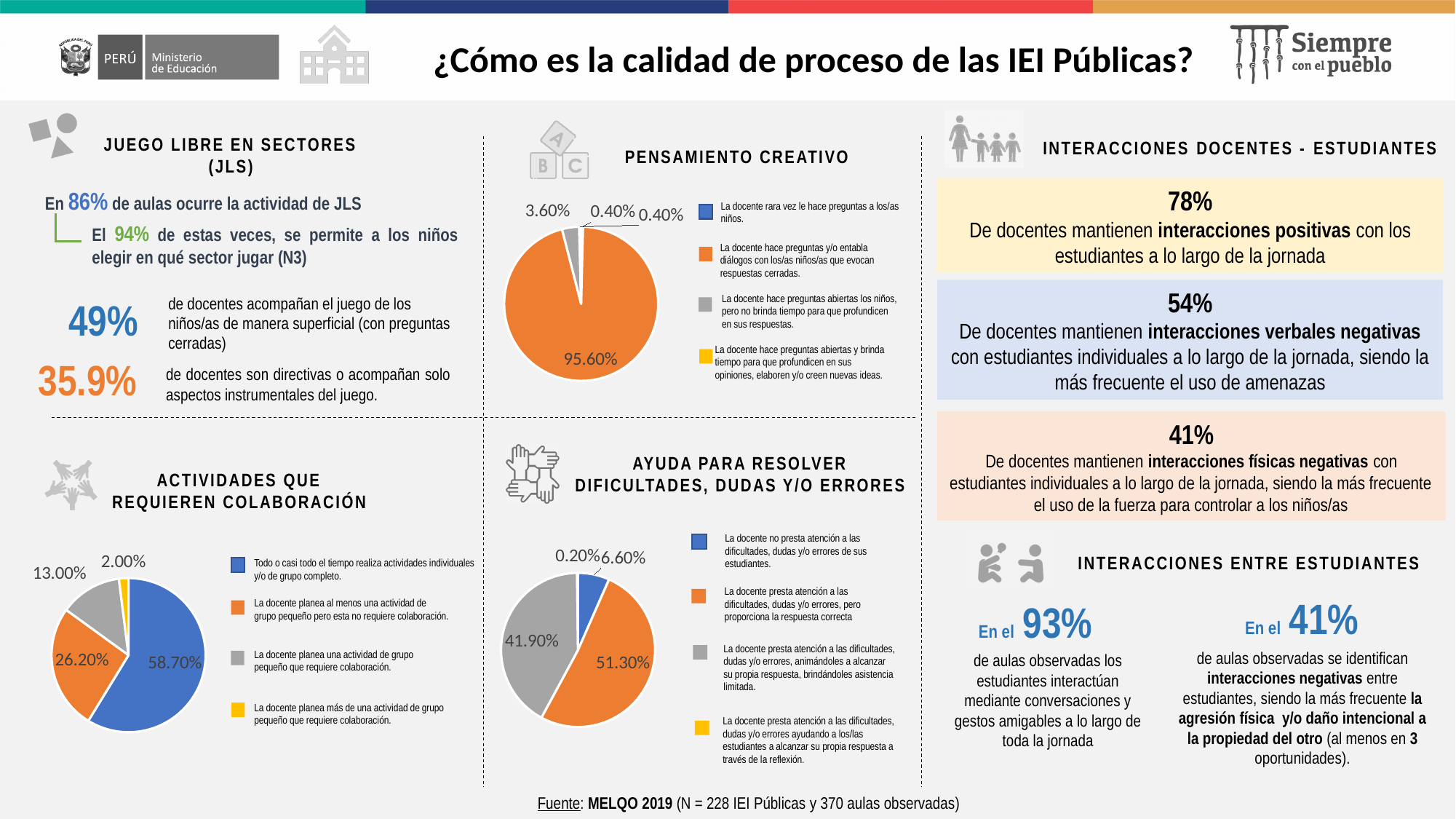
How many slices does the 'Pensamiento Creativo' pie chart have? 4 In the 'Actividades que requieren colaboración' pie chart, what is the difference between the 26.20% slice and the 13.00% slice? 13.20% In the 'Actividades que requieren colaboración' pie chart, what share corresponds to 'Todo o casi todo el tiempo realiza actividades individuales y/o de grupo completo'? 58.70% In the 'Ayuda para resolver dificultades, dudas y/o errores' pie chart, which is larger: the orange slice (51.30%) or the gray slice (41.90%)? The orange slice (51.30%) In the 'Pensamiento Creativo' pie chart, what share corresponds to the teacher asking questions and/or establishing dialogues that evoke closed answers (orange slice)? 95.60% In the 'Ayuda para resolver dificultades, dudas y/o errores' pie chart, what share corresponds to the teacher not paying attention to difficulties (blue slice)? 6.60% How many legend entries does the 'Ayuda para resolver dificultades, dudas y/o errores' pie chart list? 4 In the 'Ayuda para resolver dificultades, dudas y/o errores' pie chart, what share corresponds to the teacher paying attention but providing the correct answer (orange slice)? 51.30% In the 'Ayuda para resolver dificultades, dudas y/o errores' pie chart, what is the difference between the orange slice (51.30%) and the gray slice (41.90%)? 9.40% In the 'Actividades que requieren colaboración' pie chart, which category has the smallest share? La docente planea más de una actividad de grupo pequeño que requiere colaboración In the 'Pensamiento Creativo' pie chart, what share corresponds to the teacher asking open questions but not giving time to deepen (gray slice)? 3.60% What type of chart is used in the 'Actividades que requieren colaboración' section? Pie chart